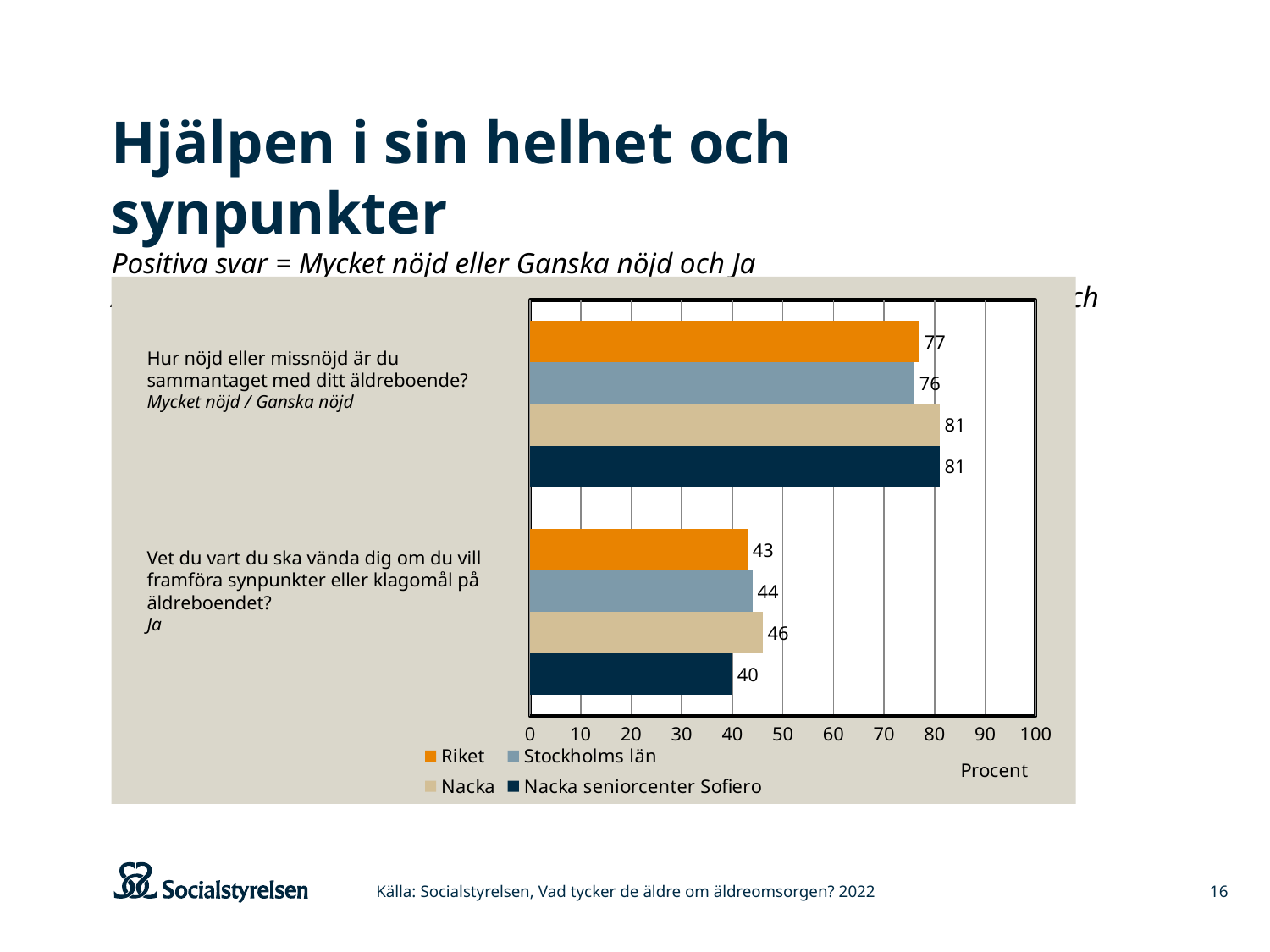
How many question categories are shown on the chart? 2 Which series has the lowest value on the question "Hur nöjd eller missnöjd är du sammantaget med ditt äldreboende?"? Stockholms län What type of chart is shown on the slide? Bar chart Which is larger: the Nacka value or the Riket value on the question "Vet du vart du ska vända dig om du vill framföra synpunkter eller klagomål på äldreboendet?"? Nacka What is the value for Stockholms län on the question "Vet du vart du ska vända dig om du vill framföra synpunkter eller klagomål på äldreboendet?"? 44 How many series does the chart legend list? 4 What label is shown on the horizontal axis of the chart? Procent What is the value for Riket on the question "Hur nöjd eller missnöjd är du sammantaget med ditt äldreboende?"? 77 What is the difference between the Nacka value and the Nacka seniorcenter Sofiero value on the question "Vet du vart du ska vända dig om du vill framföra synpunkter eller klagomål på äldreboendet?"? 6 What is the difference between the Nacka value and the Riket value on the question "Hur nöjd eller missnöjd är du sammantaget med ditt äldreboende?"? 4 What is the value for Nacka seniorcenter Sofiero on the question "Vet du vart du ska vända dig om du vill framföra synpunkter eller klagomål på äldreboendet?"? 40 Which series has the lowest value on the question "Vet du vart du ska vända dig om du vill framföra synpunkter eller klagomål på äldreboendet?"? Nacka seniorcenter Sofiero